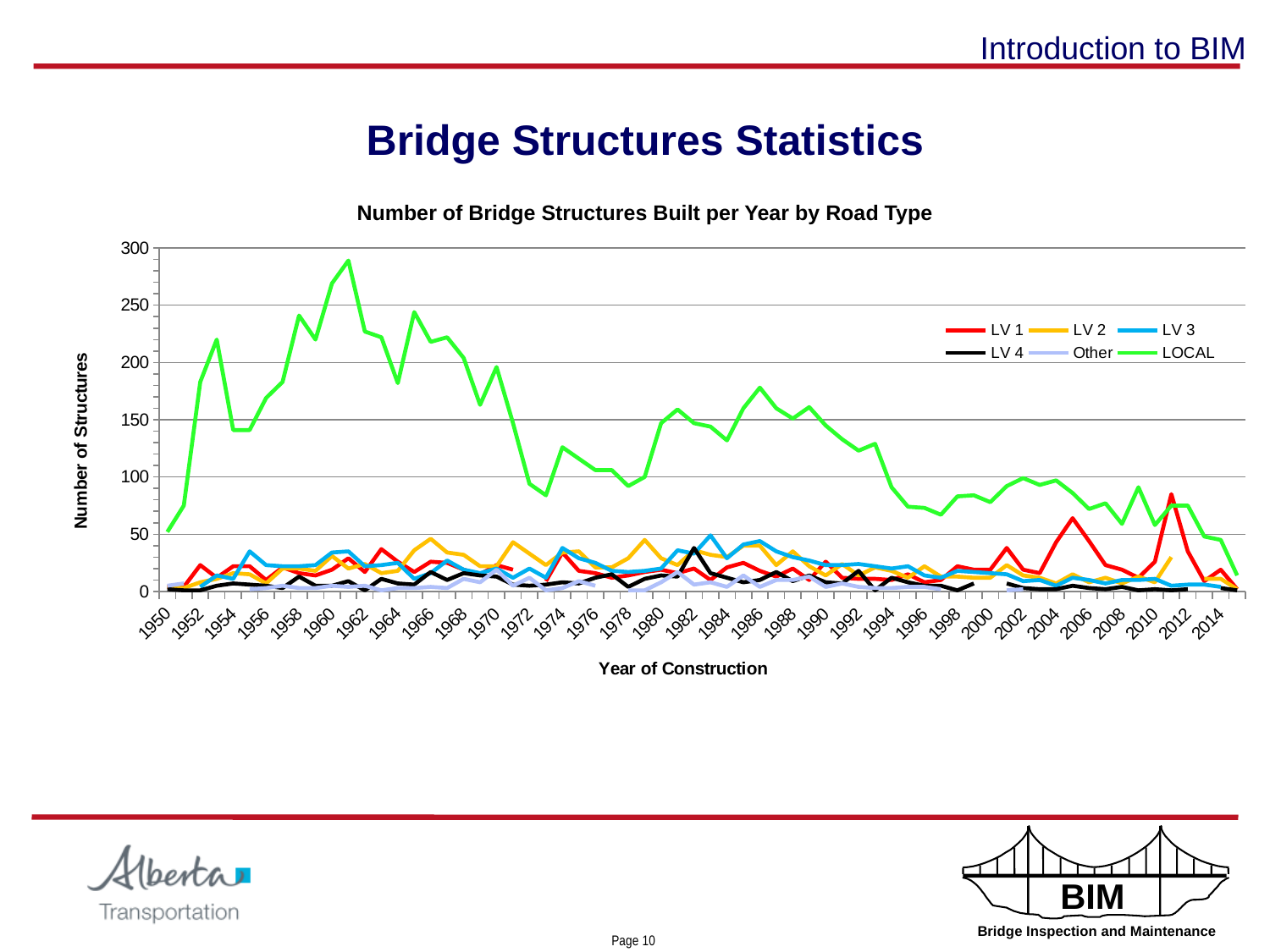
What kind of chart is shown on the slide? line chart What is the title of the chart? Number of Bridge Structures Built per Year by Road Type Which series has the highest values across most of the chart? LOCAL Is the value for LOCAL in 1986 greater or less than 150? greater What is the label of the vertical axis? Number of Structures Does the LOCAL series rise or fall between 1962 and 1974? fall In 1960, which series has the larger value, LOCAL or LV 1? LOCAL Is the value for LOCAL in 1960 greater or less than 250? greater Is the value for LOCAL in 1996 greater or less than 100? less How many series does the legend list? 6